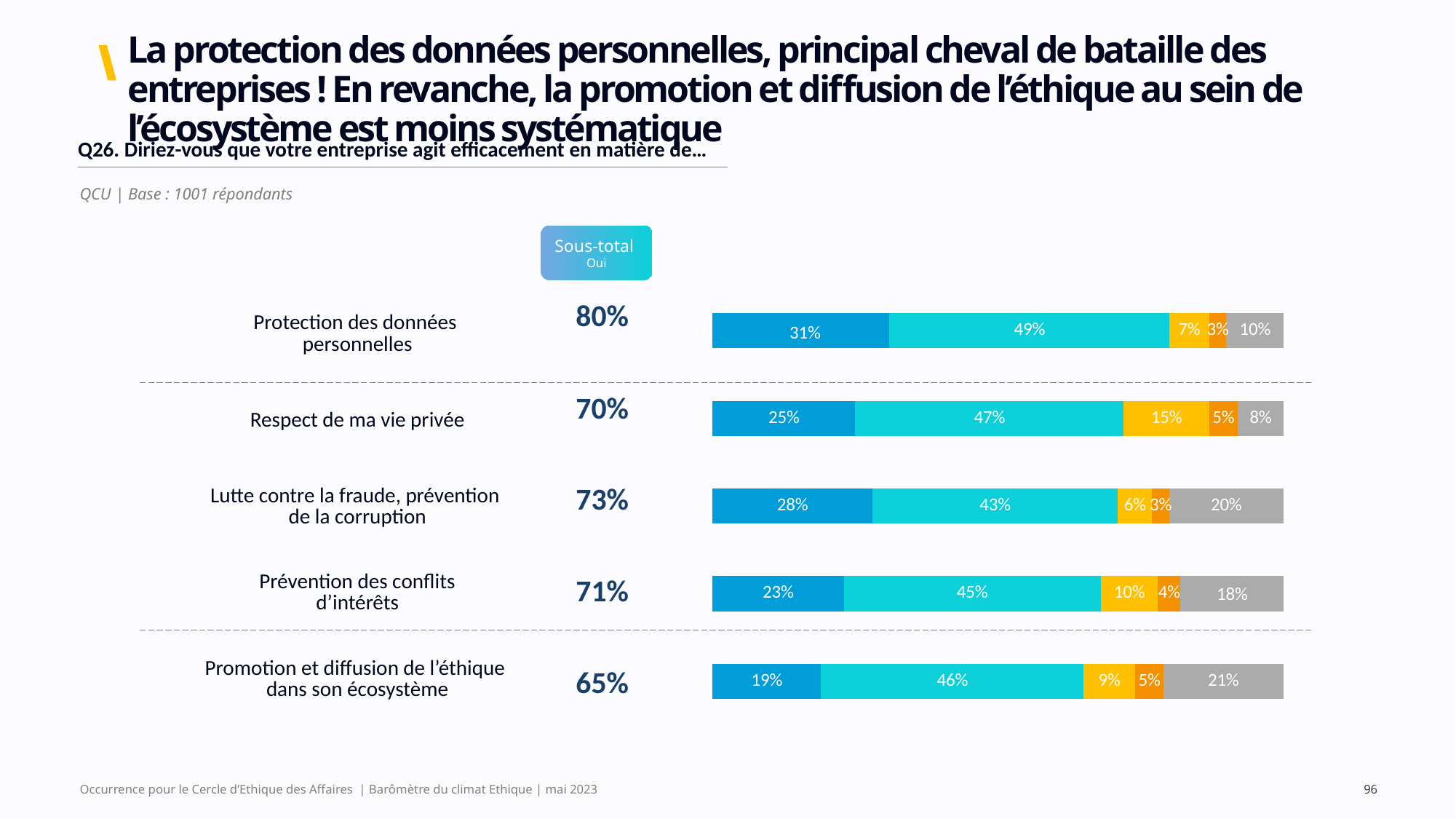
What is the difference between the yellow segment for "Respect de ma vie privée" and the yellow segment for "Protection des données personnelles"? 8 points Which has the larger grey segment: "Promotion et diffusion de l'éthique dans son écosystème" or "Protection des données personnelles"? Promotion et diffusion de l'éthique dans son écosystème Which category has the highest Sous-total Oui? Protection des données personnelles What is the Sous-total Oui value for "Protection des données personnelles"? 80% What kind of chart is shown on the slide? Stacked horizontal bar chart What is the value of the last (grey) segment of the bar for "Lutte contre la fraude, prévention de la corruption"? 20% What is the value of the cyan segment of the bar for "Prévention des conflits d'intérêts"? 45% How many respondents form the base of this chart? 1001 répondants What is the difference in Sous-total Oui between "Protection des données personnelles" and "Promotion et diffusion de l'éthique dans son écosystème"? 15 points How many categories (bars) are shown in the chart? 5 Which category has the lowest Sous-total Oui? Promotion et diffusion de l'éthique dans son écosystème What is the value of the first (dark blue) segment of the bar for "Respect de ma vie privée"? 25%